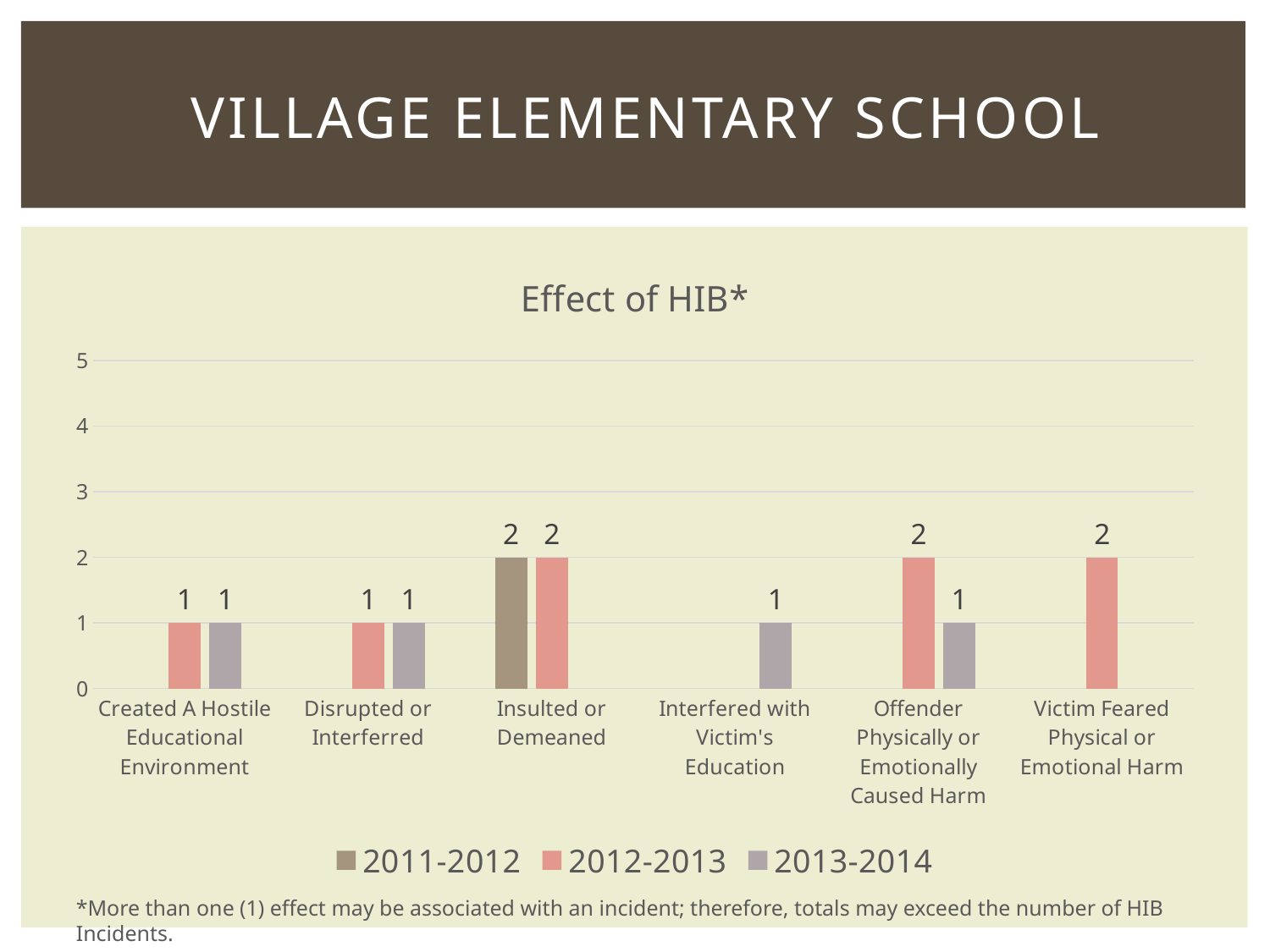
What is the difference between the 2012-2013 and 2013-2014 values in the Offender Physically or Emotionally Caused Harm category? 1 What is the value for 2011-2012 in the Insulted or Demeaned category? 2 Which category has the lowest value for the 2012-2013 series among those where it is plotted? Created A Hostile Educational Environment and Disrupted or Interferred (both 1) How many categories are shown on the x axis? 6 What type of chart is shown on the slide? bar chart How many series does the legend list? 3 In the Offender Physically or Emotionally Caused Harm category, which series has the larger value, 2012-2013 or 2013-2014? 2012-2013 Which series is shown in gray in the legend? 2013-2014 What is the value for 2013-2014 in the Interfered with Victim's Education category? 1 What is the title of the chart? Effect of HIB* What is the value for 2012-2013 in the Insulted or Demeaned category? 2 What is the value for 2012-2013 in the Victim Feared Physical or Emotional Harm category? 2